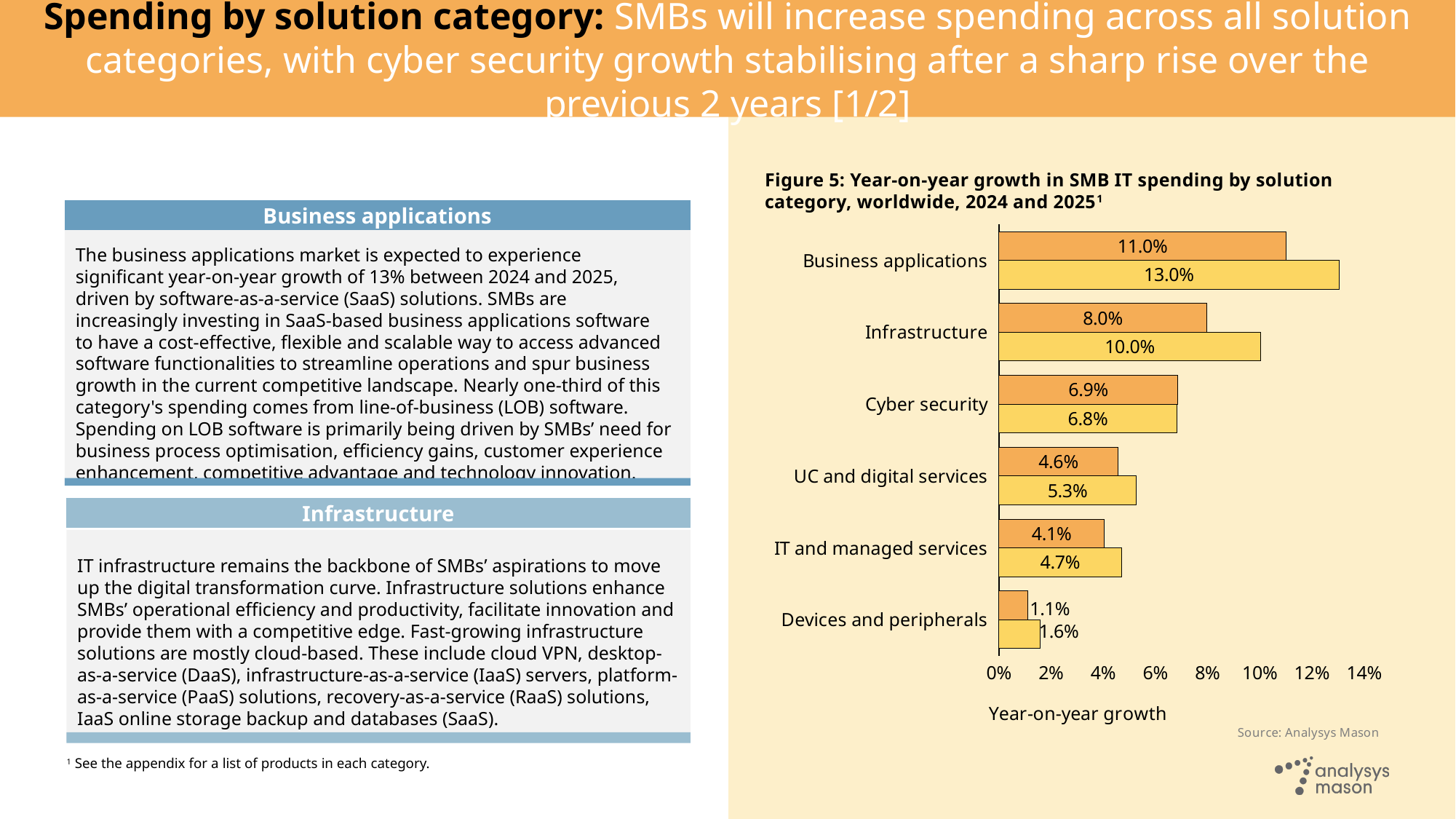
How many solution categories are shown in Figure 5? 6 In Figure 5, which is larger for UC and digital services: the orange (upper) bar or the yellow (lower) bar? The yellow (lower) bar Which category has the highest year-on-year growth in Figure 5? Business applications In Figure 5, what is the difference between the yellow (lower) bar and the orange (upper) bar for Infrastructure? 2.0% What kind of chart is Figure 5? Bar chart In Figure 5, what is the value of the yellow (lower) bar for Devices and peripherals? 1.6% In Figure 5, what is the value of the orange (upper) bar for Cyber security? 6.9% In Figure 5, what is the value of the yellow (lower) bar for Business applications? 13.0% In Figure 5, is the yellow (lower) bar for IT and managed services greater or less than 6%? less Which category has the lowest year-on-year growth in Figure 5? Devices and peripherals In Figure 5, what is the value of the orange (upper) bar for Infrastructure? 8.0% What is the x-axis label of Figure 5? Year-on-year growth